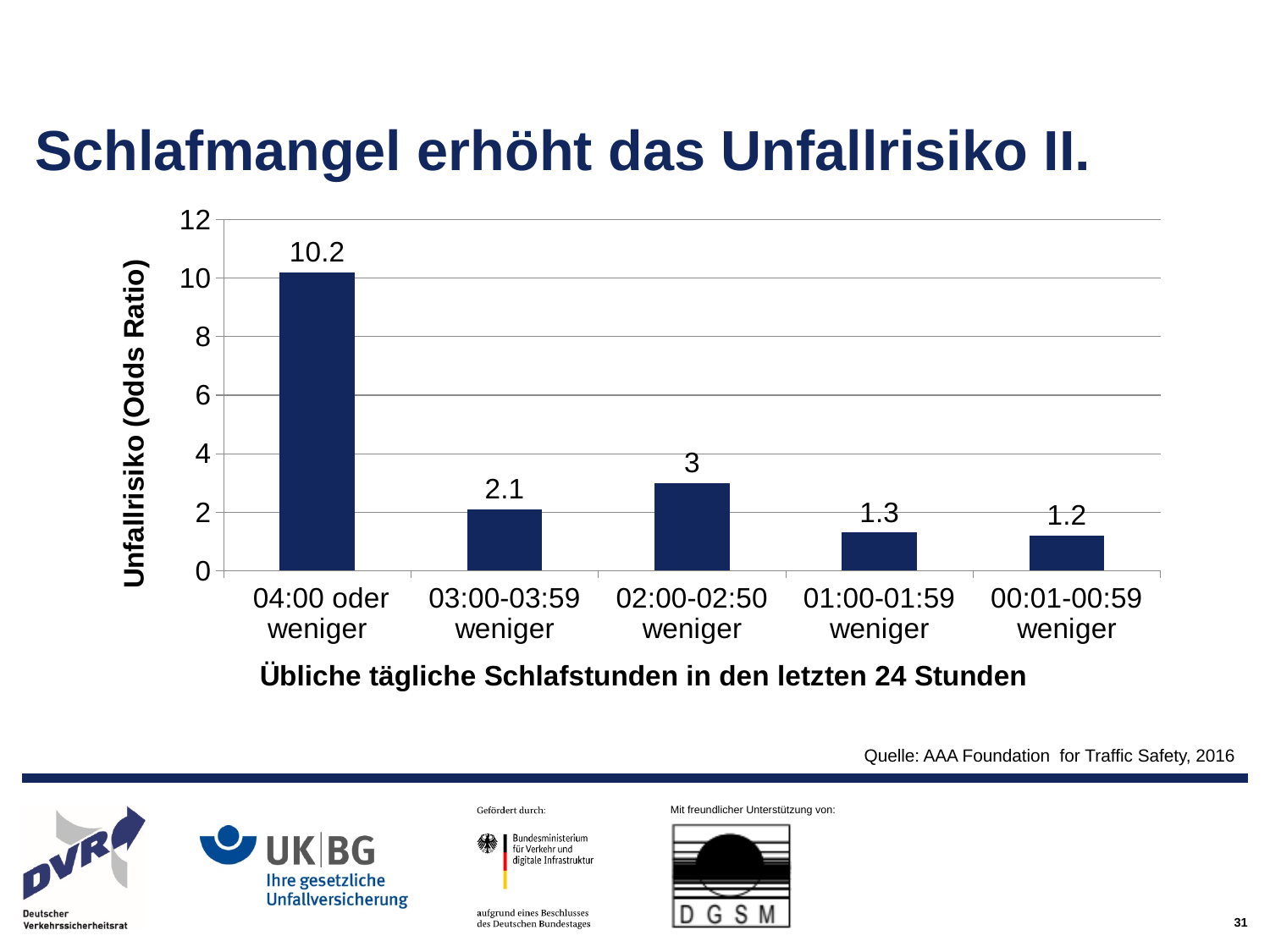
What kind of chart is shown on the slide? bar chart Which has a larger Odds Ratio: "03:00-03:59 weniger" or "02:00-02:50 weniger"? 02:00-02:50 weniger Which category has the lowest Unfallrisiko (Odds Ratio)? 00:01-00:59 weniger Which category has the highest Unfallrisiko (Odds Ratio)? 04:00 oder weniger What is the Unfallrisiko (Odds Ratio) for the category "00:01-00:59 weniger"? 1.2 What is the label of the x axis? Übliche tägliche Schlafstunden in den letzten 24 Stunden What is the label of the y axis? Unfallrisiko (Odds Ratio) What is the Unfallrisiko (Odds Ratio) for the category "04:00 oder weniger"? 10.2 What is the Unfallrisiko (Odds Ratio) for the category "02:00-02:50 weniger"? 3 Is the value for "01:00-01:59 weniger" greater or less than 2? less How many categories are shown on the x axis? 5 What is the difference between the Odds Ratio for "04:00 oder weniger" and "03:00-03:59 weniger"? 8.1